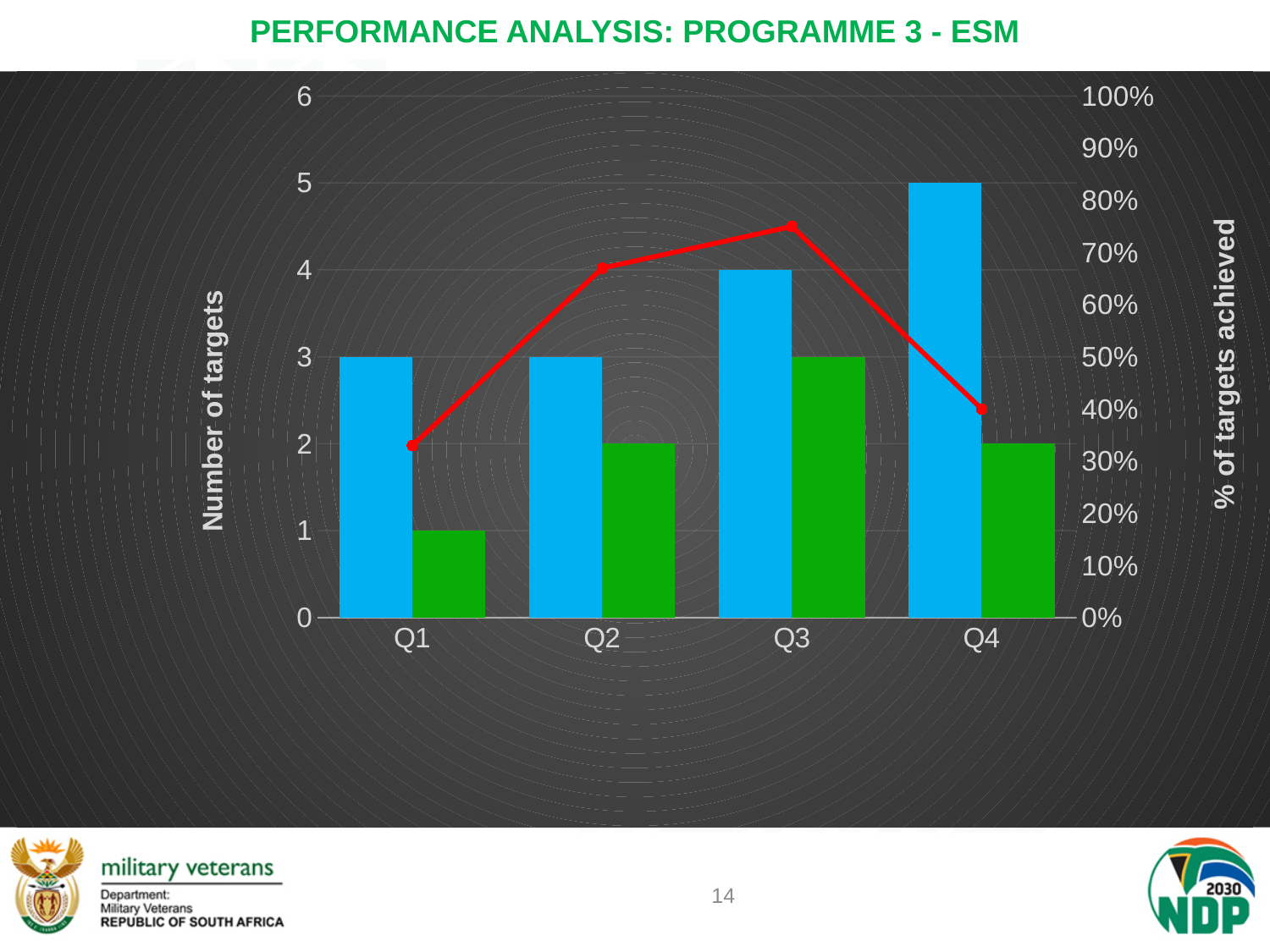
What is the value of the blue bar for Q4? 5 What is the label of the right-hand vertical axis? % of targets achieved What is the value of the green bar for Q3? 3 What is the value of the green bar for Q1? 1 Which quarter has the highest blue bar? Q4 Is the value of the red line for Q3 greater or less than 70%? greater What is the difference between the blue bar and the green bar for Q4? 3 Is the value of the red line for Q1 greater or less than 40%? less Which quarter has the lowest green bar? Q1 Which is larger for Q3, the blue bar or the green bar? the blue bar How many quarters are shown on the x axis? 4 What is the value of the blue bar for Q2? 3